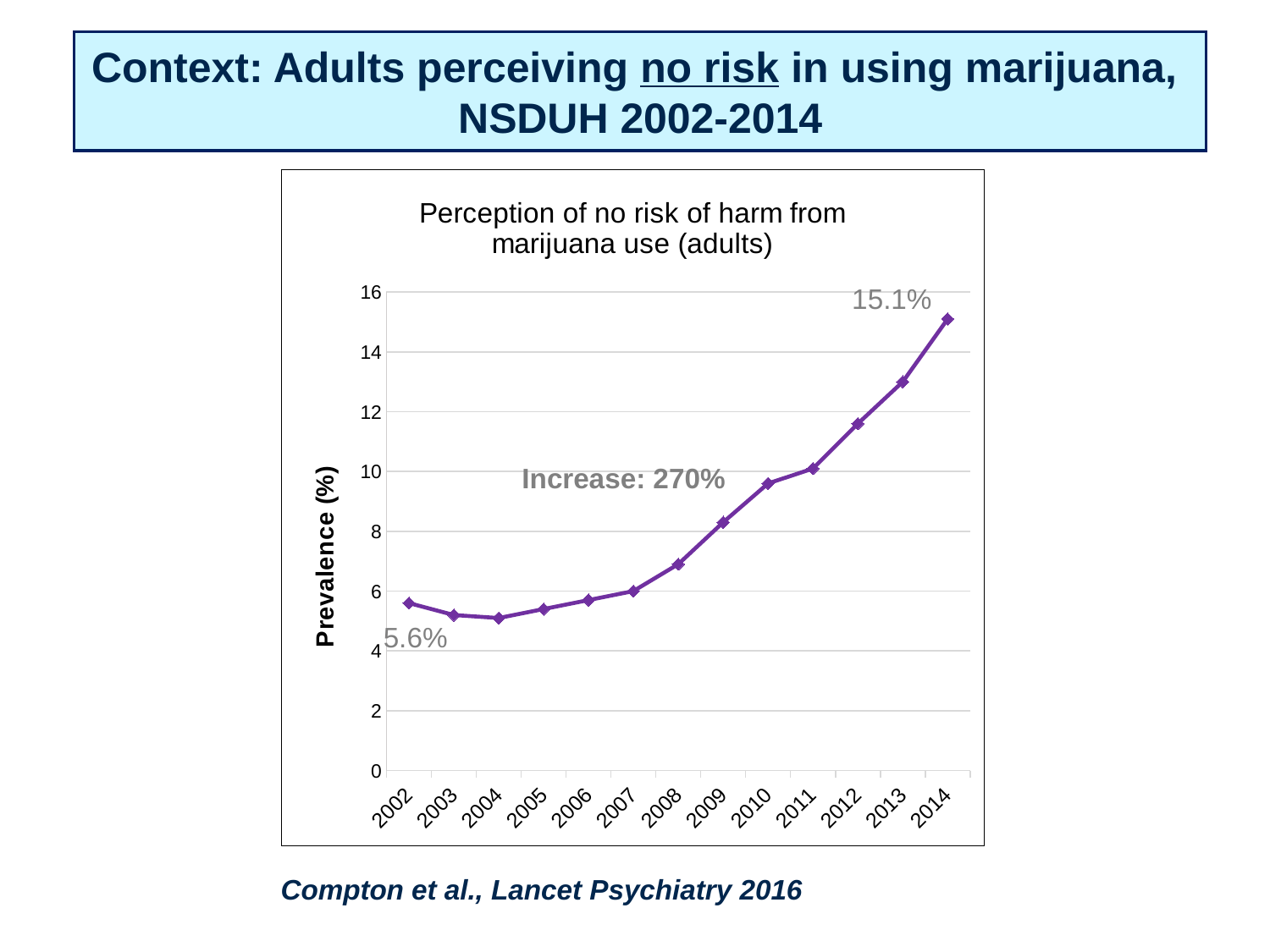
Is the value for 2010 greater or less than 8? greater What is the value for 2002? 5.6% What percentage increase is annotated on the chart? 270% Which is larger, the value for 2002 or the value for 2014? 2014 Is the value for 2007 greater or less than 8? less Do the values generally rise or fall from 2002 to 2014? rise How many years are plotted on the x axis? 13 Which year has the highest prevalence? 2014 What kind of chart is shown? line chart What is the value for 2014? 15.1% Is the value for 2012 greater or less than 10? greater What is the difference between the 2014 value and the 2002 value? 9.5 percentage points